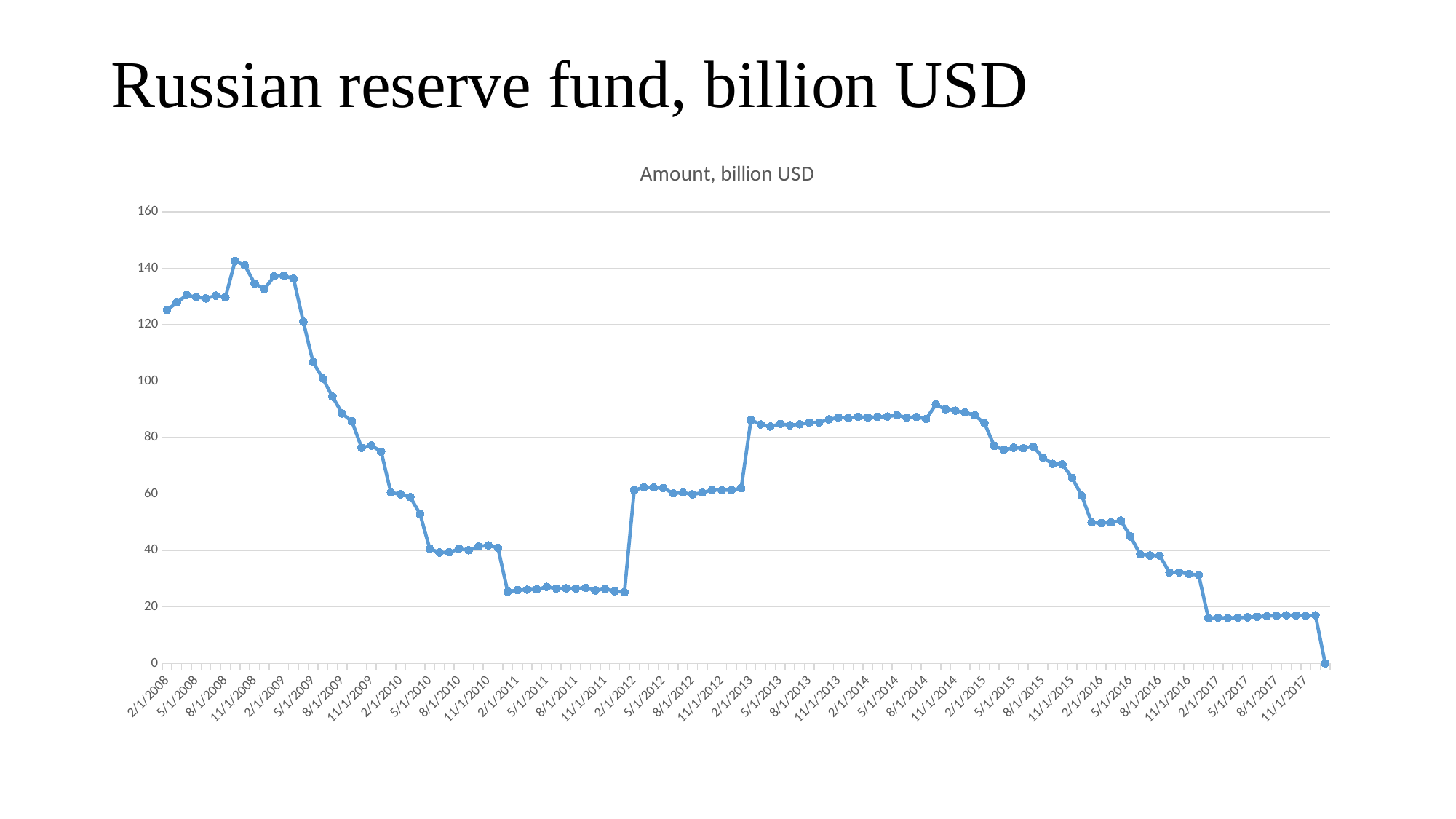
Is the value for 2/1/2017 greater or less than 20? less Is the value for 5/1/2009 greater or less than 100? greater Which is larger, the value for 2/1/2013 or the value for 2/1/2012? 2/1/2013 Which is larger, the value for 2/1/2008 or the value for 2/1/2017? 2/1/2008 Is the value for 8/1/2014 greater or less than 100? less What kind of chart is shown on the slide? line chart Overall, do the values rise or fall from 2/1/2008 to the end of the series? fall What is the title of the chart? Amount, billion USD